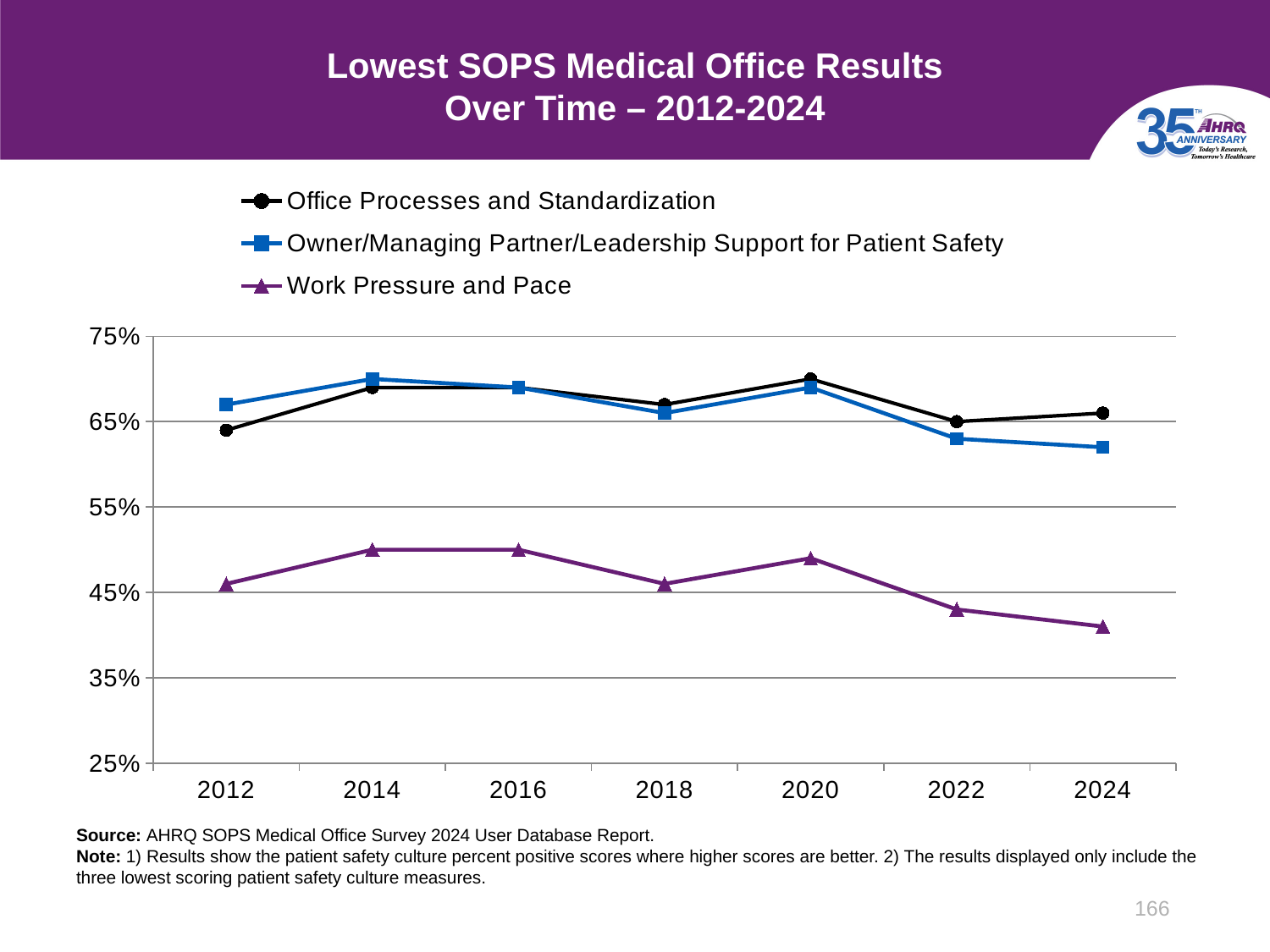
Is the value for Work Pressure and Pace in 2024 greater or less than 45%? less In 2024, which is higher: Office Processes and Standardization or Owner/Managing Partner/Leadership Support for Patient Safety? Office Processes and Standardization Does the Work Pressure and Pace line rise or fall from 2020 to 2024? fall What kind of chart is shown on the slide? line chart What marker shape is used for the Work Pressure and Pace series in the legend? triangle How many years are plotted along the x axis? 7 Is the value for Owner/Managing Partner/Leadership Support for Patient Safety in 2024 greater or less than 65%? less For Work Pressure and Pace, which year has the larger value: 2014 or 2024? 2014 Which series has the lowest value in 2024? Work Pressure and Pace How many series does the legend list? 3 Is the value for Work Pressure and Pace in 2012 greater or less than 55%? less